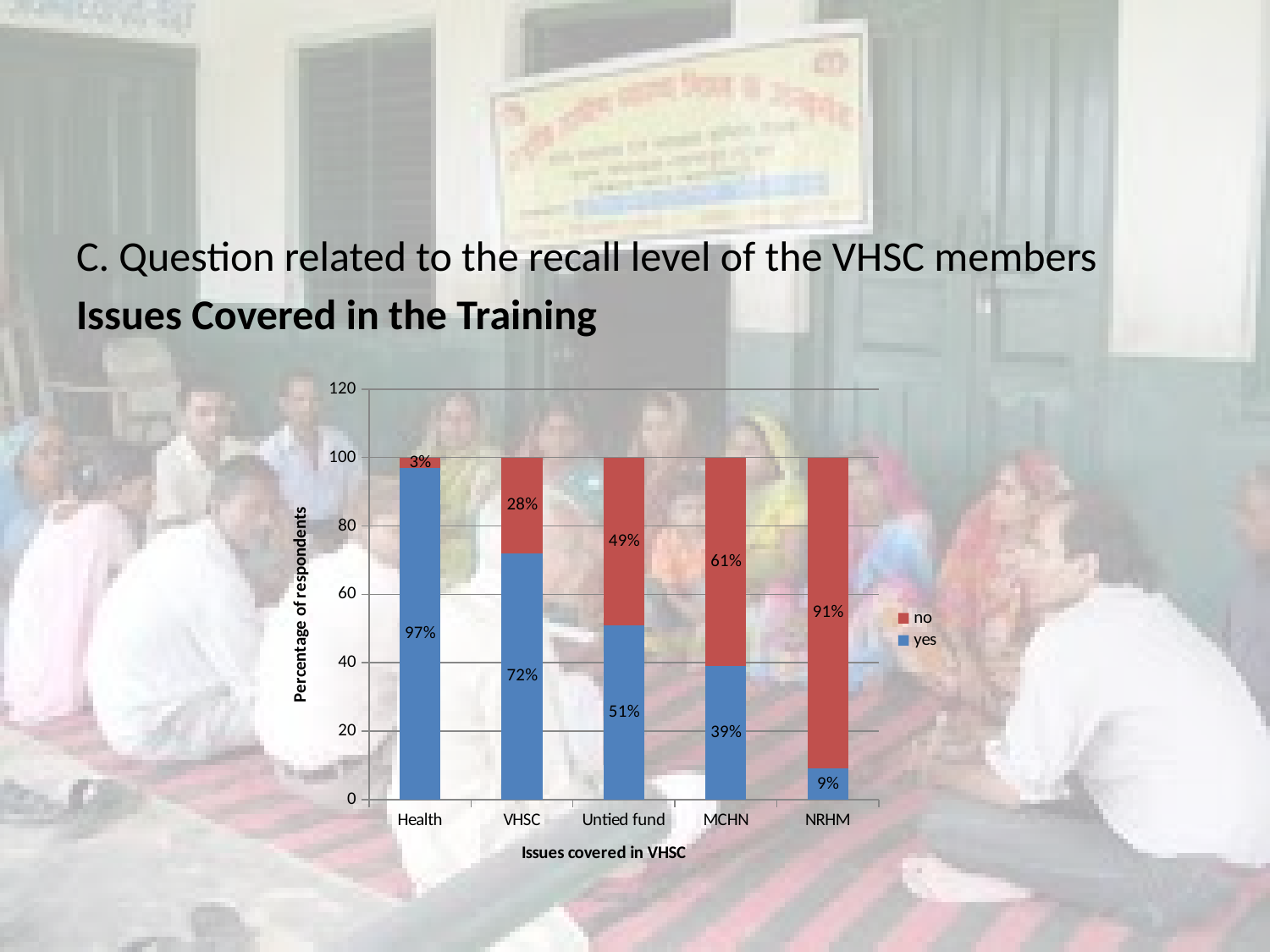
Do the "yes" values rise or fall from Health to NRHM along the x axis? Fall How many series does the legend list? 2 What is the "yes" value for NRHM? 9% What percentage of respondents answered "yes" for Health? 97% What kind of chart is shown on the slide? Stacked bar chart What percentage of respondents answered "no" for MCHN? 61% Which issue has the highest "yes" percentage? Health What is the label of the y axis? Percentage of respondents What is the difference between the "no" values for NRHM and VHSC? 63% Which issue has the lowest "yes" percentage? NRHM How many issues are shown on the x axis? 5 Which is larger, the "yes" value for VHSC or the "yes" value for Untied fund? VHSC